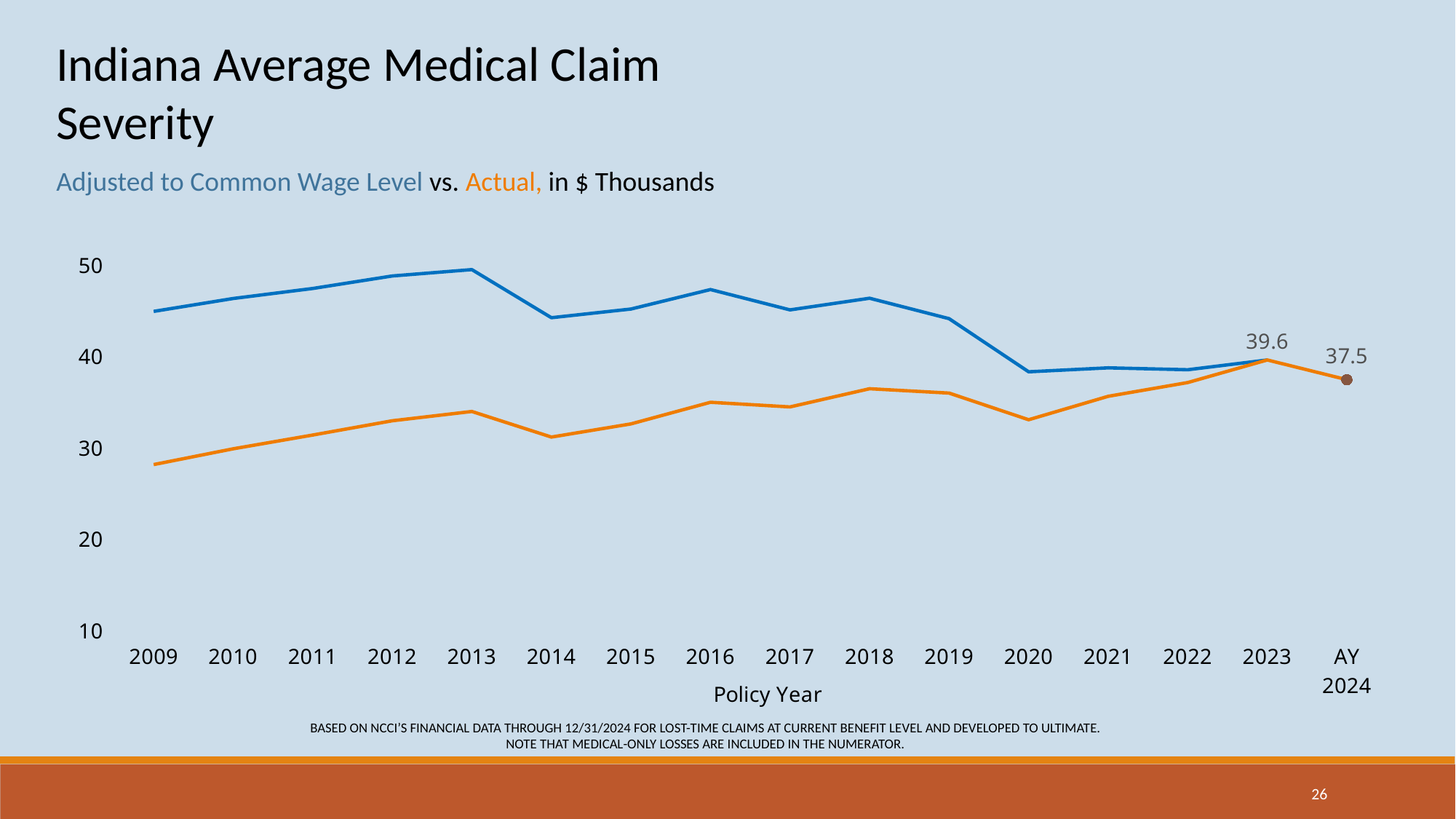
What is the value labelled at policy year 2023? 39.6 How many policy-year points are shown along the x axis? 16 What is the value labelled at AY 2024? 37.5 What kind of chart is shown on the slide? line chart What is the difference between the labelled value for 2023 and the labelled value for AY 2024? 2.1 In 2009, which series has the larger value, Adjusted to Common Wage Level or Actual? Adjusted to Common Wage Level How many data series are plotted on the chart? 2 In which policy year is the Actual series at its lowest? 2009 Does the Actual series rise or fall from 2009 to 2013? rise What is the title of the x axis? Policy Year Is the Actual value for 2009 greater or less than 30? less Is the Adjusted to Common Wage Level value for 2013 greater or less than 40? greater